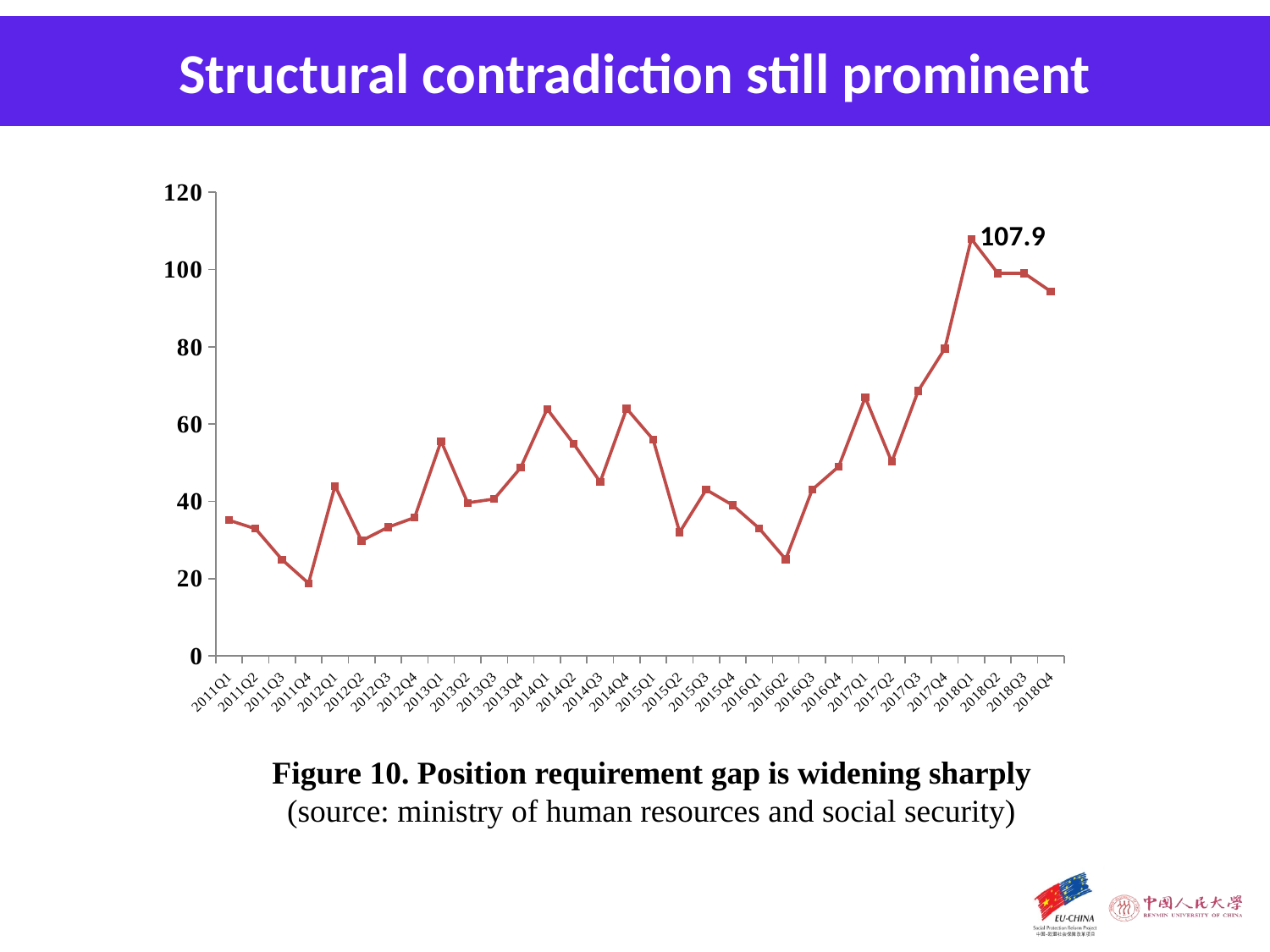
Is the value for 2016Q2 greater or less than 20? greater Is the value for 2014Q1 greater or less than 60? greater Is the value for 2015Q2 greater or less than 40? less What kind of chart is shown on the slide? line chart Which quarter has the lowest value on the chart? 2011Q4 Which is larger, the value for 2017Q1 or the value for 2017Q2? 2017Q1 What is the figure caption given below the chart? Figure 10. Position requirement gap is widening sharply Which quarter has the highest value on the chart? 2018Q1 What value is labelled on the chart for 2018Q1? 107.9 How many quarterly data points are plotted on the chart? 32 Do the values generally rise or fall from 2016Q2 to 2018Q1? rise